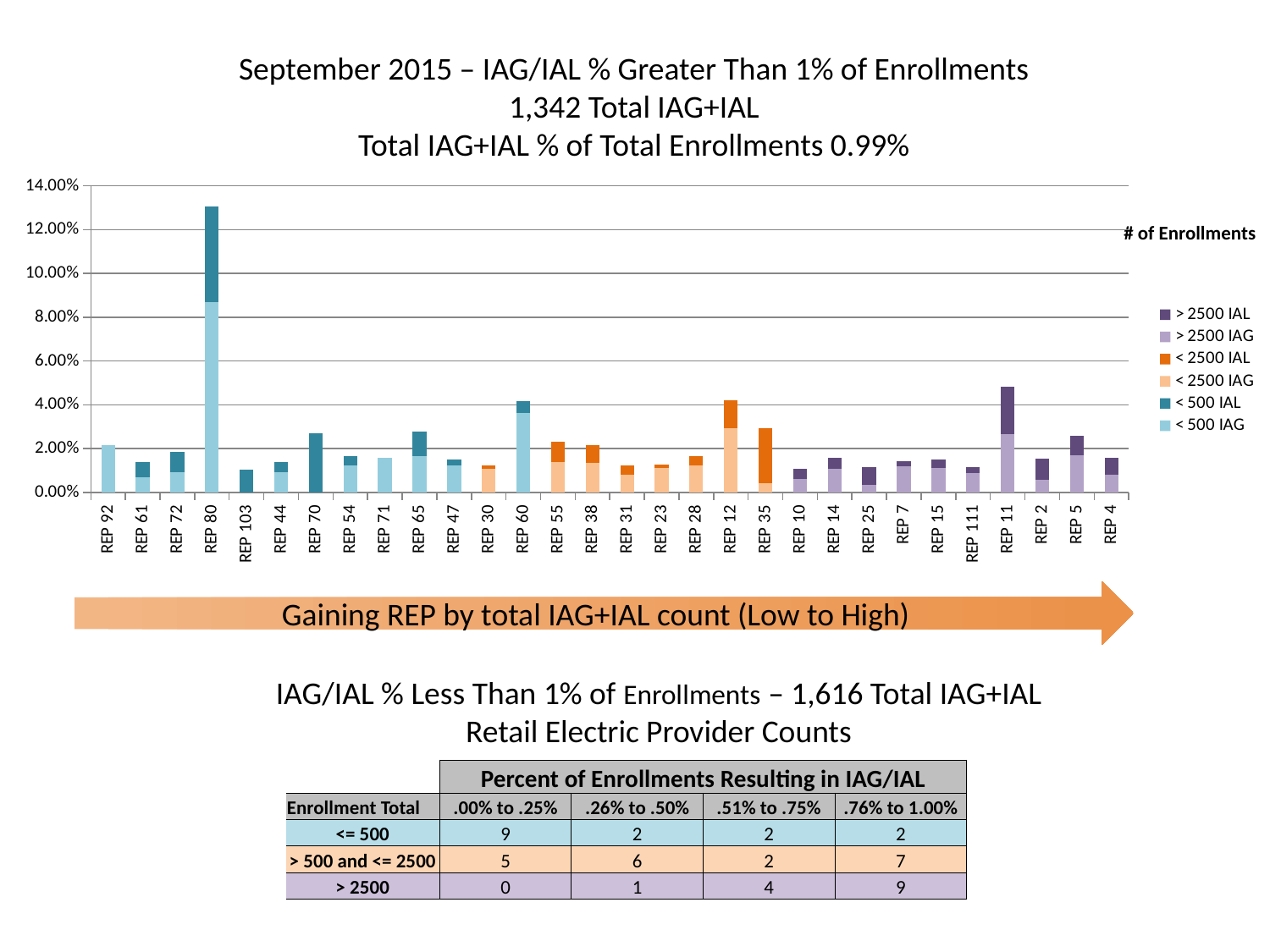
What kind of chart is shown on the slide? Stacked bar chart Which has the larger total bar, REP 12 or REP 55? REP 12 How many series does the chart's legend list? 6 Which REP has the highest total bar in the chart? REP 80 Which has the larger total bar, REP 80 or REP 11? REP 80 How many REP categories are plotted along the x axis of the chart? 30 Is the total value for REP 80 greater or less than 12.00%? greater Is the total value for REP 11 greater or less than 4.00%? greater What is the title shown above the chart's legend? # of Enrollments Is the total value for REP 35 greater or less than 4.00%? less Which legend entry is shown in the darkest purple colour? > 2500 IAL